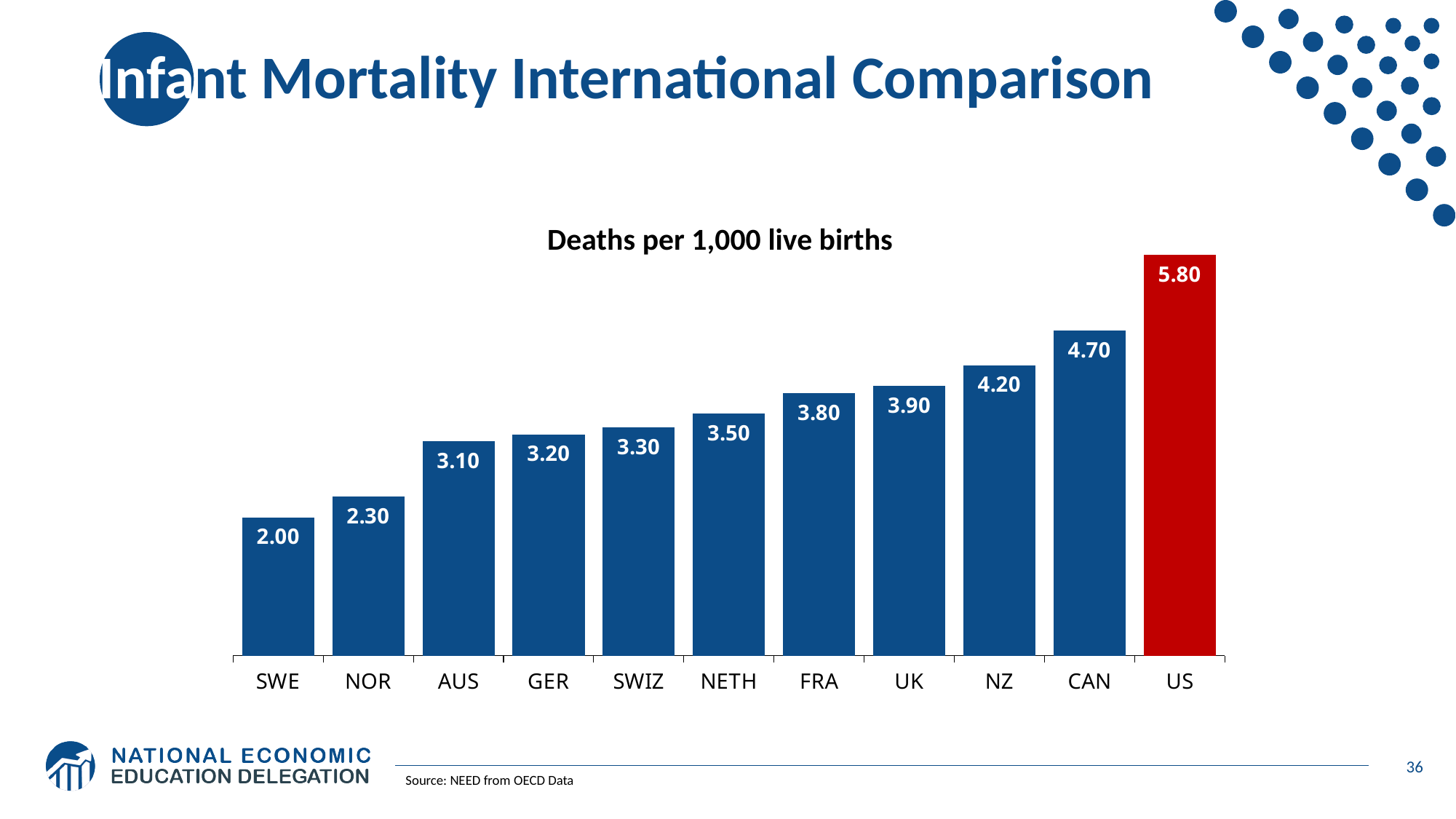
What is the difference between the values for FRA and SWE? 1.80 What is the value for the US? 5.80 Which country has the lowest value? SWE Which bar is coloured red rather than blue? US How many countries are shown in the chart? 11 What is the value for NZ? 4.20 Which country has the highest value? US What is the difference between the values for the US and CAN? 1.10 What kind of chart is this? Bar chart What is the value for GER? 3.20 Do the values rise or fall from left to right along the x axis? Rise Which is larger, the value for NETH or the value for NOR? NETH